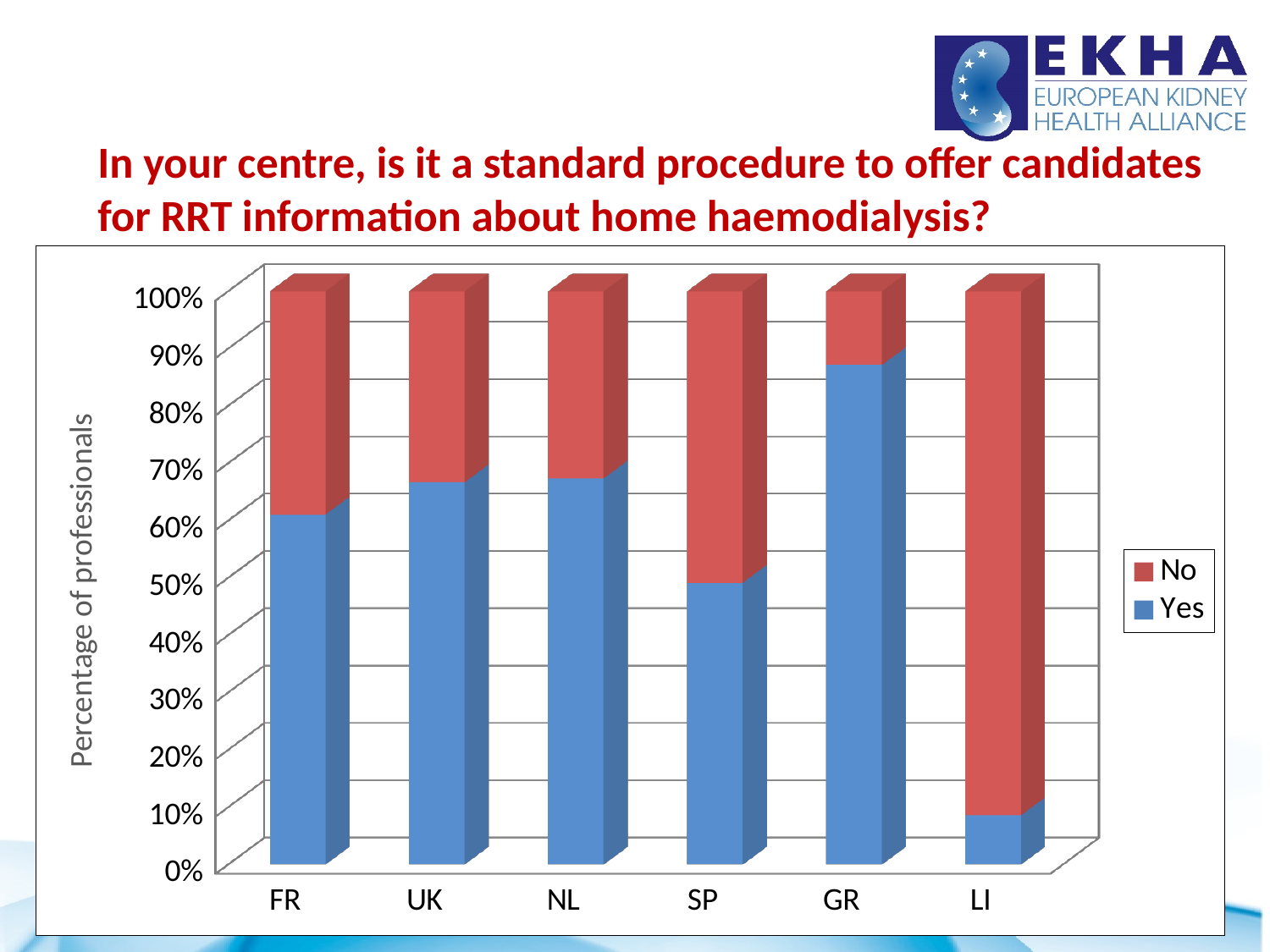
Is the 'Yes' share for GR greater or less than 80%? greater Which colour represents the 'No' responses in the chart? Red Which country has a larger 'Yes' share, GR or SP? GR What is the label on the vertical axis of the chart? Percentage of professionals What kind of chart is shown on the slide? Stacked bar chart Which country has the highest share of 'Yes' responses? GR Which country has the lowest share of 'Yes' responses? LI Is the 'Yes' share for SP greater or less than 70%? less Is the 'Yes' share for FR greater or less than 50%? greater How many series does the chart legend list? 2 How many countries are shown on the x axis of the chart? 6